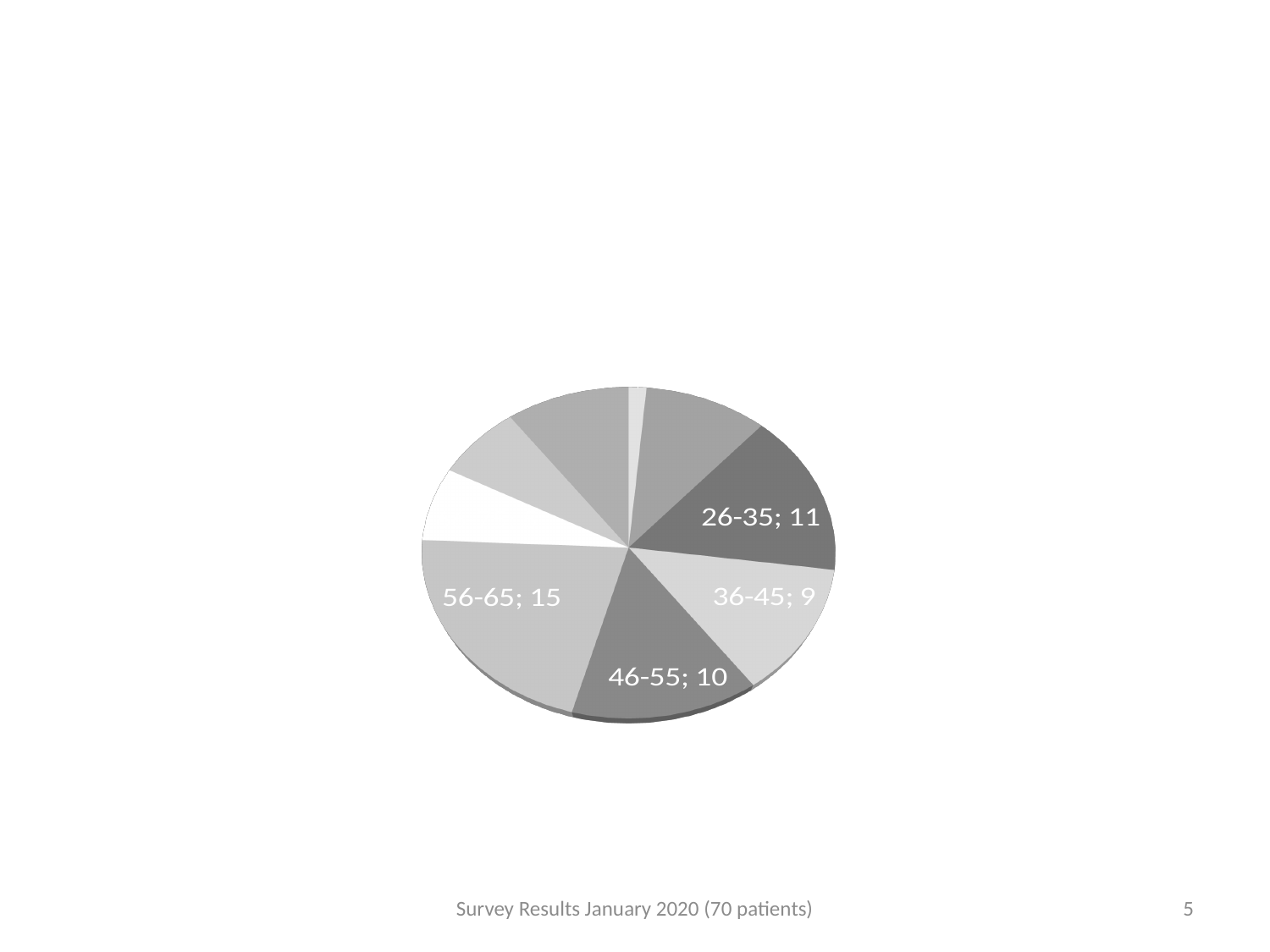
What is the difference between the values for 56-65 and 46-55? 5 What kind of chart is shown on the slide? pie chart What is the difference between the values for 56-65 and 36-45? 6 What text appears in the footer below the chart? Survey Results January 2020 (70 patients) Which labeled age group has the largest slice? 56-65 What is the value for the 36-45 age group? 9 What is the value for the 26-35 age group? 11 What is the value for the 46-55 age group? 10 What is the value for the 56-65 age group? 15 Which is larger, the value for 26-35 or the value for 46-55? 26-35 Which is larger, the value for 36-45 or the value for 56-65? 56-65 Which labeled age group has the smallest value? 36-45